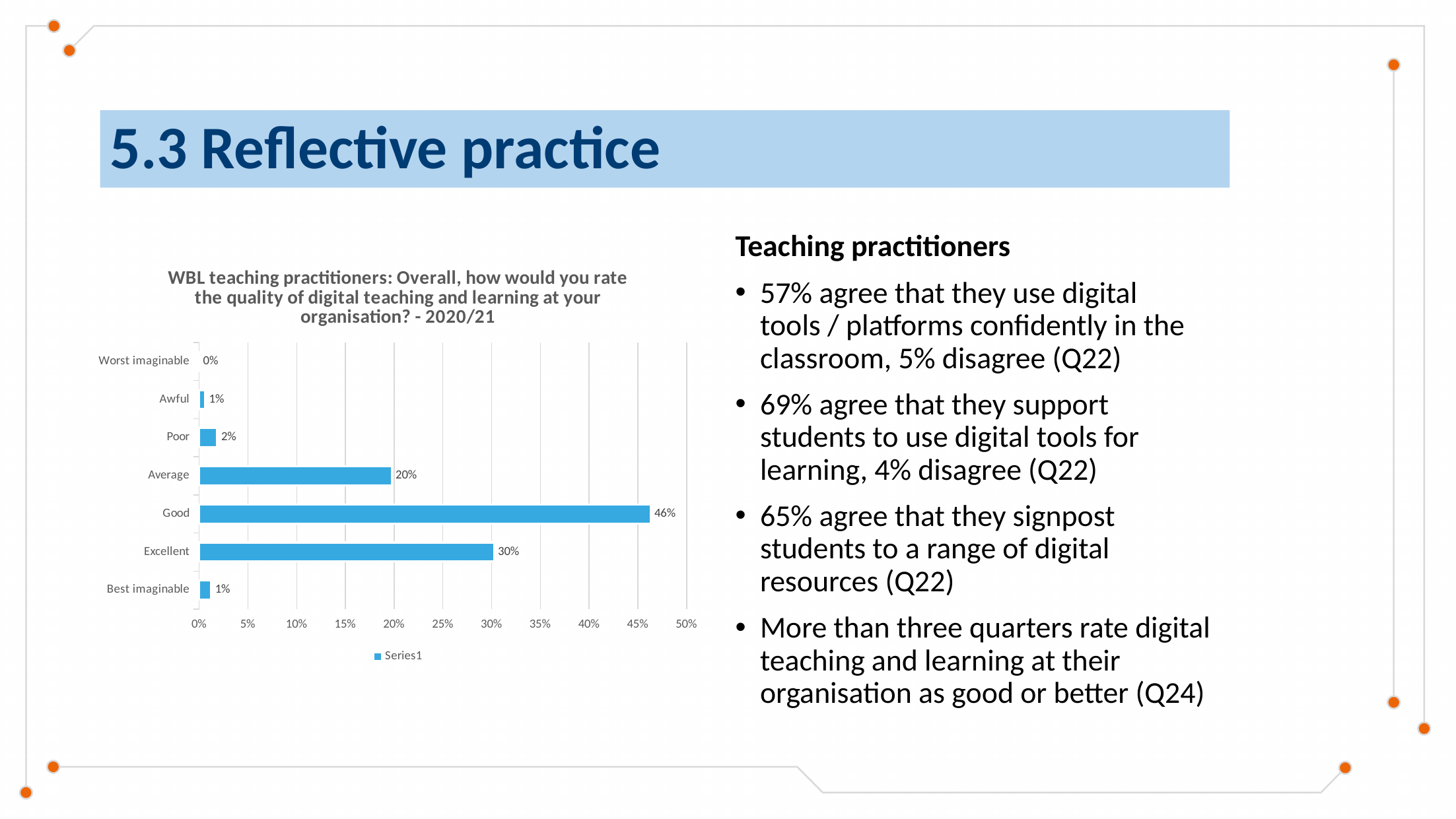
Which category has the highest value in the chart? Good What value is shown for the Average category? 20% What series name does the chart legend show? Series1 What value is shown for the Worst imaginable category? 0% Which is larger, the value for Average or the value for Poor? Average Which category has the lowest value in the chart? Worst imaginable What percentage of WBL teaching practitioners rated the quality of digital teaching and learning as Good? 46% What value is shown for the Excellent category? 30% What kind of chart is shown on the slide? Bar chart How many categories are shown on the chart's vertical axis? 7 Is the value for Good greater or less than 40%? greater What is the difference between the values for Good and Excellent? 16%